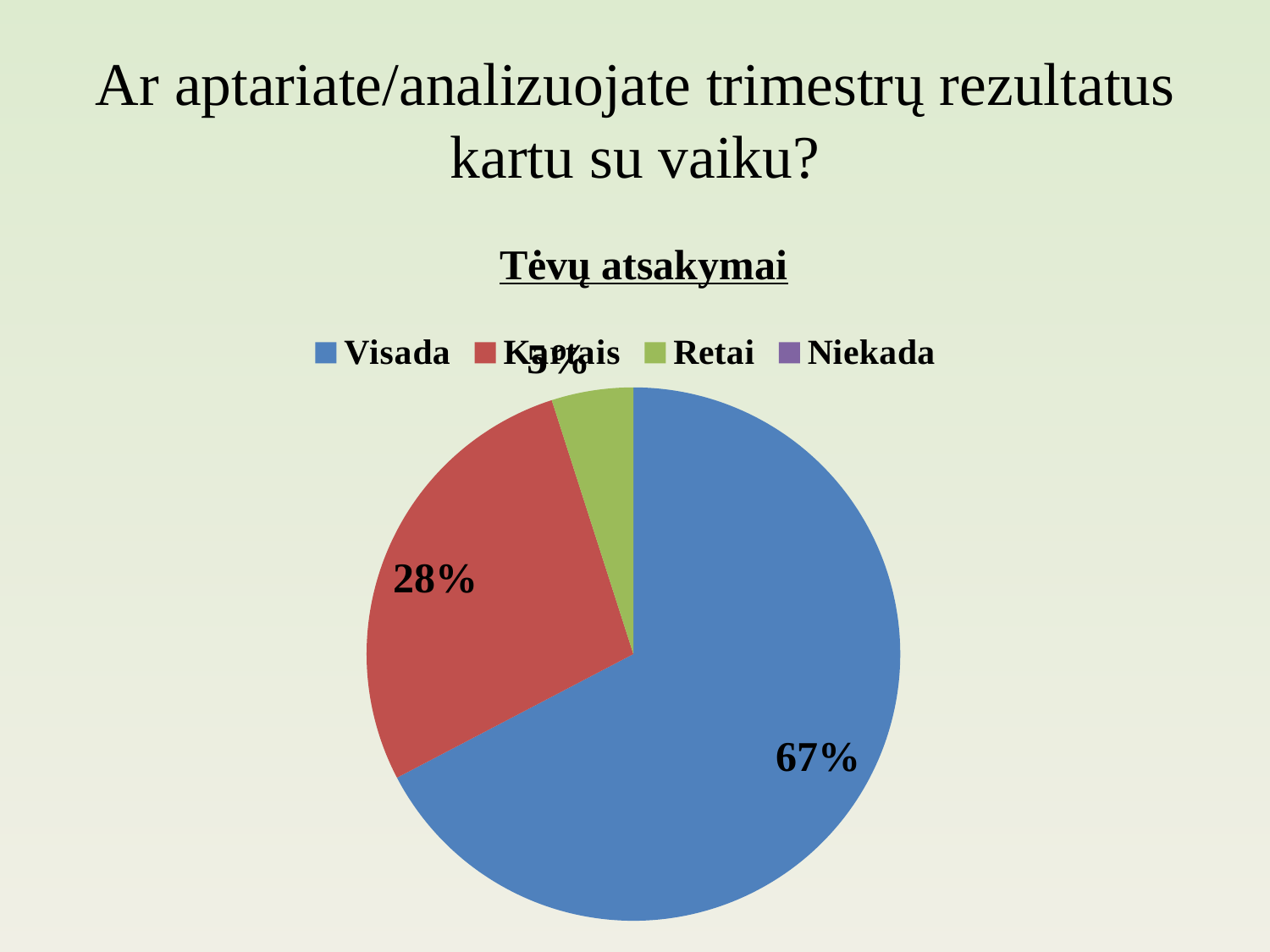
Which is larger, the share for Visada or the share for Kartais? Visada Which legend entry has no visible slice in the pie? Niekada Which category has the largest slice of the pie? Visada How many entries does the legend list? 4 What kind of chart is shown on the slide? pie chart Is the share for Visada greater or less than 50%? greater What share of the pie is labelled for Kartais? 28% Which of the visible slices is the smallest? Retai What is the title of the chart? Tėvų atsakymai Which colour represents Visada in the pie chart? blue What is the difference in percentage points between the Visada and Kartais shares? 39 What share of the pie is labelled for Visada? 67%